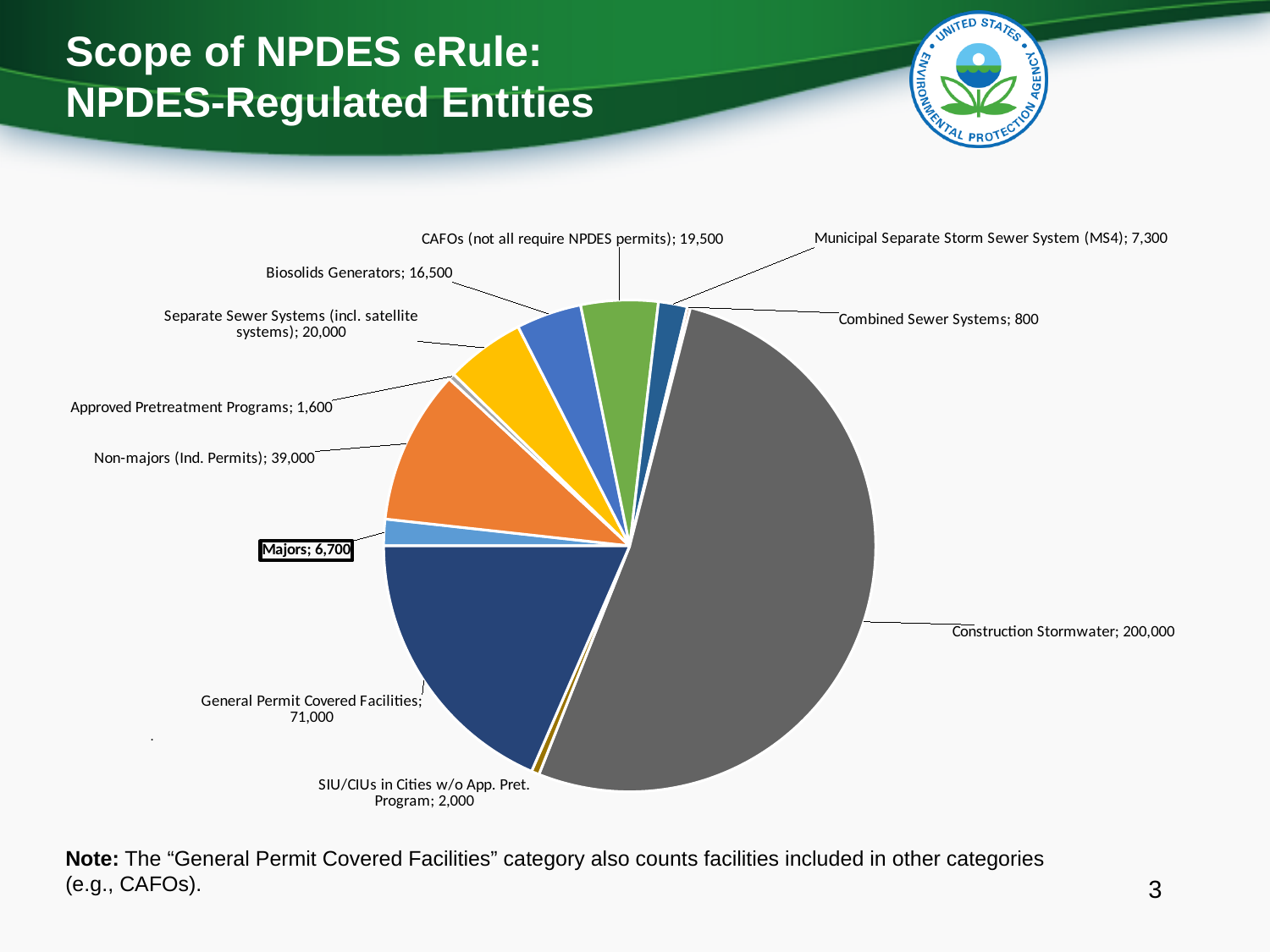
What is the value for General Permit Covered Facilities? 71,000 What is the value for Majors? 6,700 Which category has the smallest value? Combined Sewer Systems What is the value for Construction Stormwater? 200,000 What is the value for Combined Sewer Systems? 800 What is the value for Biosolids Generators? 16,500 What type of chart is shown on the slide? pie chart Which category has the largest slice of the pie? Construction Stormwater What is the difference between Separate Sewer Systems (incl. satellite systems) and Biosolids Generators? 3,500 What is the difference between Construction Stormwater and General Permit Covered Facilities? 129,000 Which is larger, Non-majors (Ind. Permits) or Majors? Non-majors (Ind. Permits) How many categories (slices) does the pie chart show? 11